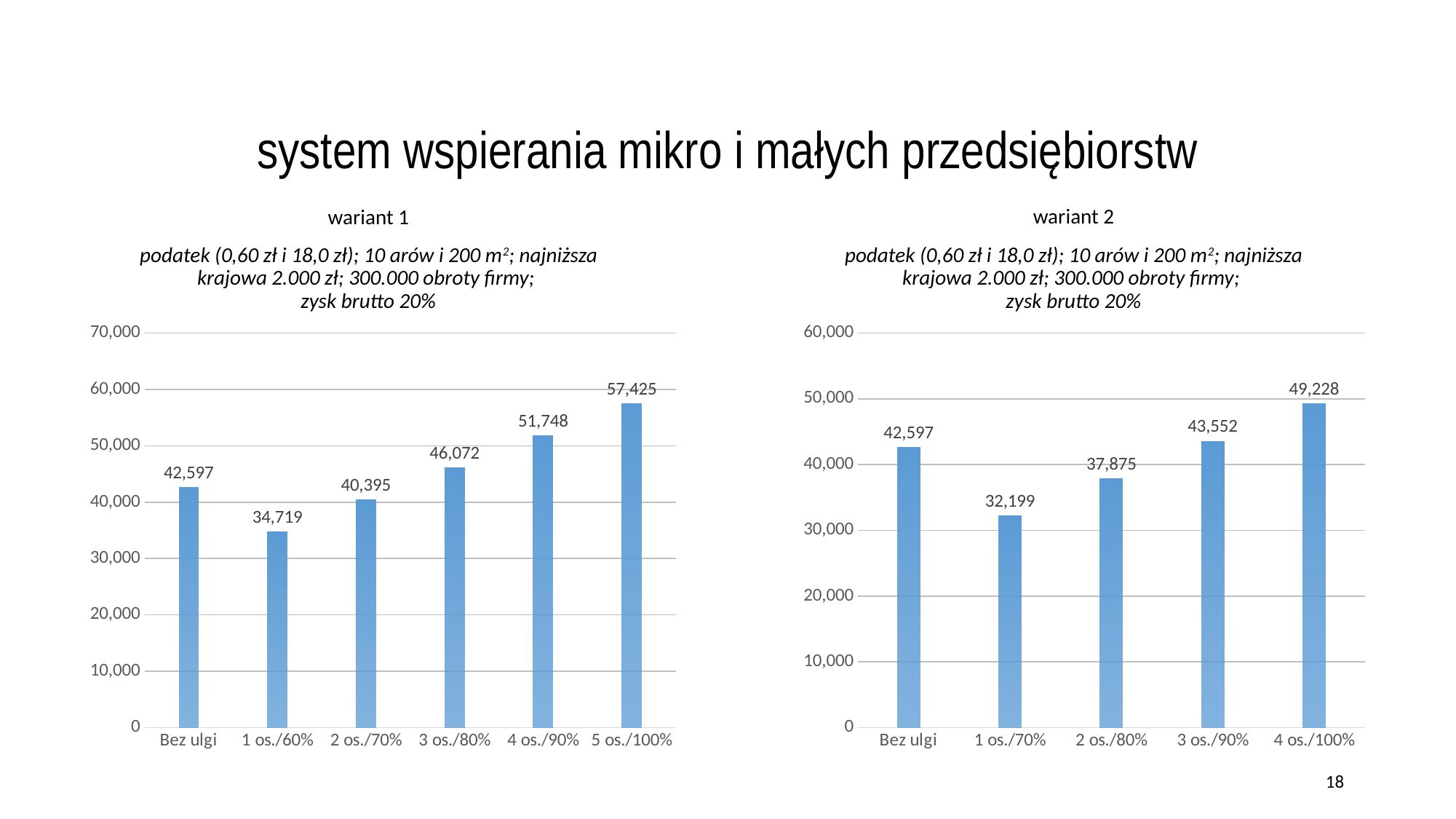
In the wariant 1 chart, what is the value for 5 os./100%? 57,425 How many categories are shown in the wariant 2 chart? 5 In the wariant 2 chart, what is the difference between the values for 4 os./100% and 1 os./70%? 17,029 In the wariant 1 chart, what is the difference between the values for 5 os./100% and Bez ulgi? 14,828 In the wariant 1 chart, what is the value for Bez ulgi? 42,597 How many categories are shown in the wariant 1 chart? 6 In the wariant 2 chart, which is larger: the value for Bez ulgi or the value for 3 os./90%? 3 os./90% In the wariant 1 chart, which category has the lowest value? 1 os./60% In the wariant 2 chart, which category has the highest value? 4 os./100% What kind of chart is the wariant 2 chart? bar chart In the wariant 2 chart, what is the value for 1 os./70%? 32,199 In the wariant 1 chart, is the value for 2 os./70% greater or less than 50,000? less